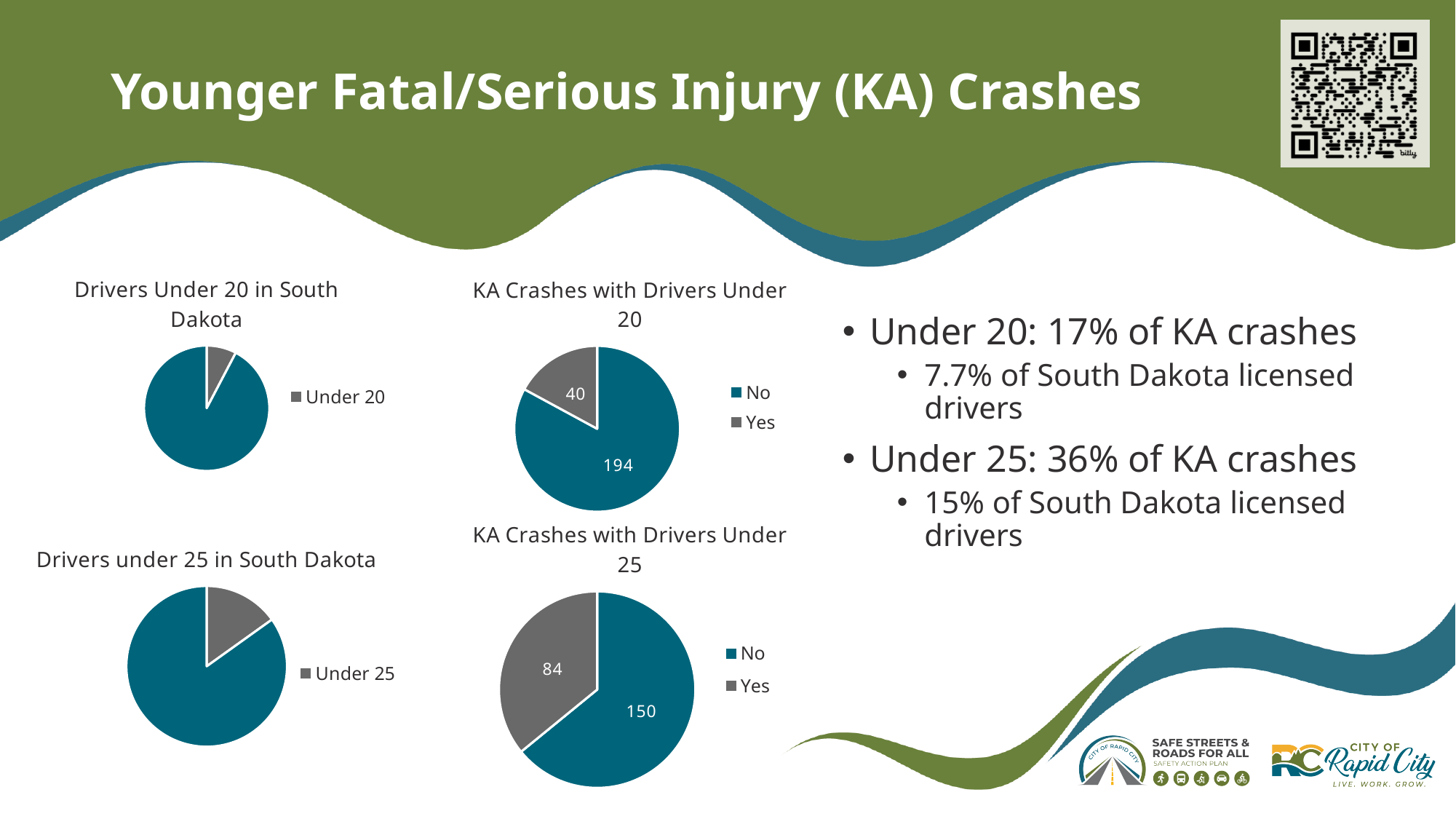
In the chart titled "KA Crashes with Drivers Under 25", what is the value for the "No" slice? 150 In the chart titled "KA Crashes with Drivers Under 25", what is the difference between the "No" and "Yes" values? 66 In the chart titled "KA Crashes with Drivers Under 25", what is the total of the two slices? 234 In the chart titled "KA Crashes with Drivers Under 20", what is the value for the "Yes" slice? 40 In the chart titled "KA Crashes with Drivers Under 20", what is the value for the "No" slice? 194 What kind of chart is the chart titled "Drivers Under 20 in South Dakota"? pie chart In the chart titled "KA Crashes with Drivers Under 25", which slice is larger, "No" or "Yes"? No Is the "Yes" value larger in the chart titled "KA Crashes with Drivers Under 25" or in the chart titled "KA Crashes with Drivers Under 20"? KA Crashes with Drivers Under 25 What is the only legend entry shown for the chart titled "Drivers under 25 in South Dakota"? Under 25 In the chart titled "KA Crashes with Drivers Under 25", what is the value for the "Yes" slice? 84 How many entries does the legend of the chart titled "KA Crashes with Drivers Under 20" list? 2 In the chart titled "KA Crashes with Drivers Under 20", what is the difference between the "No" and "Yes" values? 154